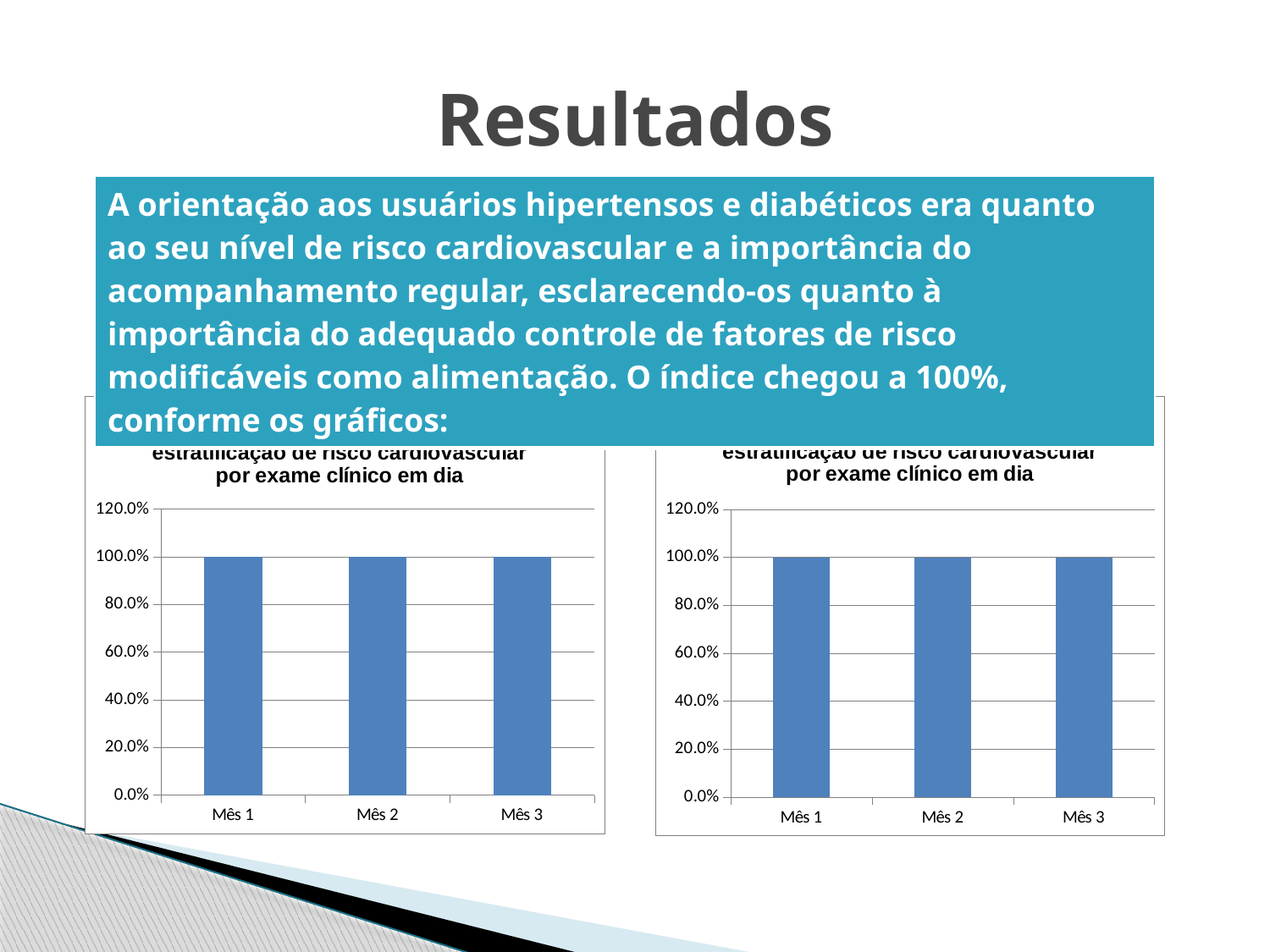
In the right chart, is the value for Mês 2 greater or less than 80.0%? greater How many bars does the right chart have? 3 In the right chart, what is the difference between the values for Mês 1 and Mês 2? 0.0% How many categories are shown on the x axis of the left chart? 3 In the left chart, is the value for Mês 3 greater or less than 60.0%? greater In the left chart, what is the value for Mês 1? 100.0% In the right chart, what is the value for Mês 3? 100.0% In the left chart, do the values rise, fall or stay the same from Mês 1 to Mês 3? Stay the same In the left chart, what is the value for Mês 2? 100.0% What kind of chart is the left chart? Bar chart What is the highest value shown on the y axis of the right chart? 120.0% What kind of chart is the right chart? Bar chart